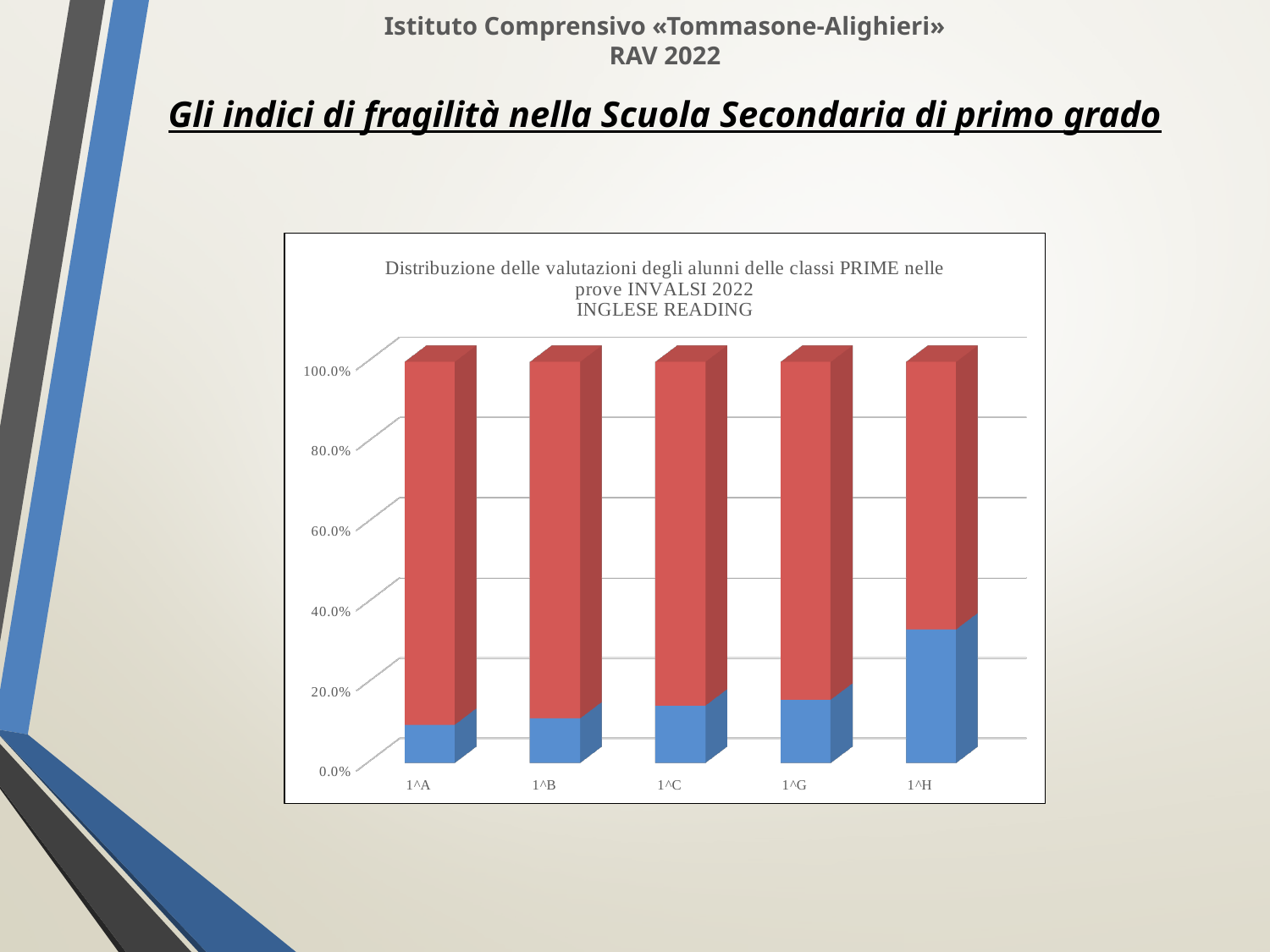
What kind of chart is shown on the slide? Stacked bar chart What is the total height of each stacked bar? 100.0% Which class has a larger blue segment, 1^A or 1^H? 1^H What colour is the top segment of each stacked bar? Red Which class has the largest blue (bottom) segment? 1^H Which class has a larger red segment, 1^A or 1^H? 1^A How many classes are shown on the x axis of the chart? 5 Is the blue segment for 1^H greater or less than 20.0%? greater Does the blue segment rise or fall moving from 1^A to 1^H along the x axis? rise Is the blue segment for 1^H greater or less than 40.0%? less What is the title of the chart? Distribuzione delle valutazioni degli alunni delle classi PRIME nelle prove INVALSI 2022 INGLESE READING Is the blue segment for 1^A greater or less than 20.0%? less